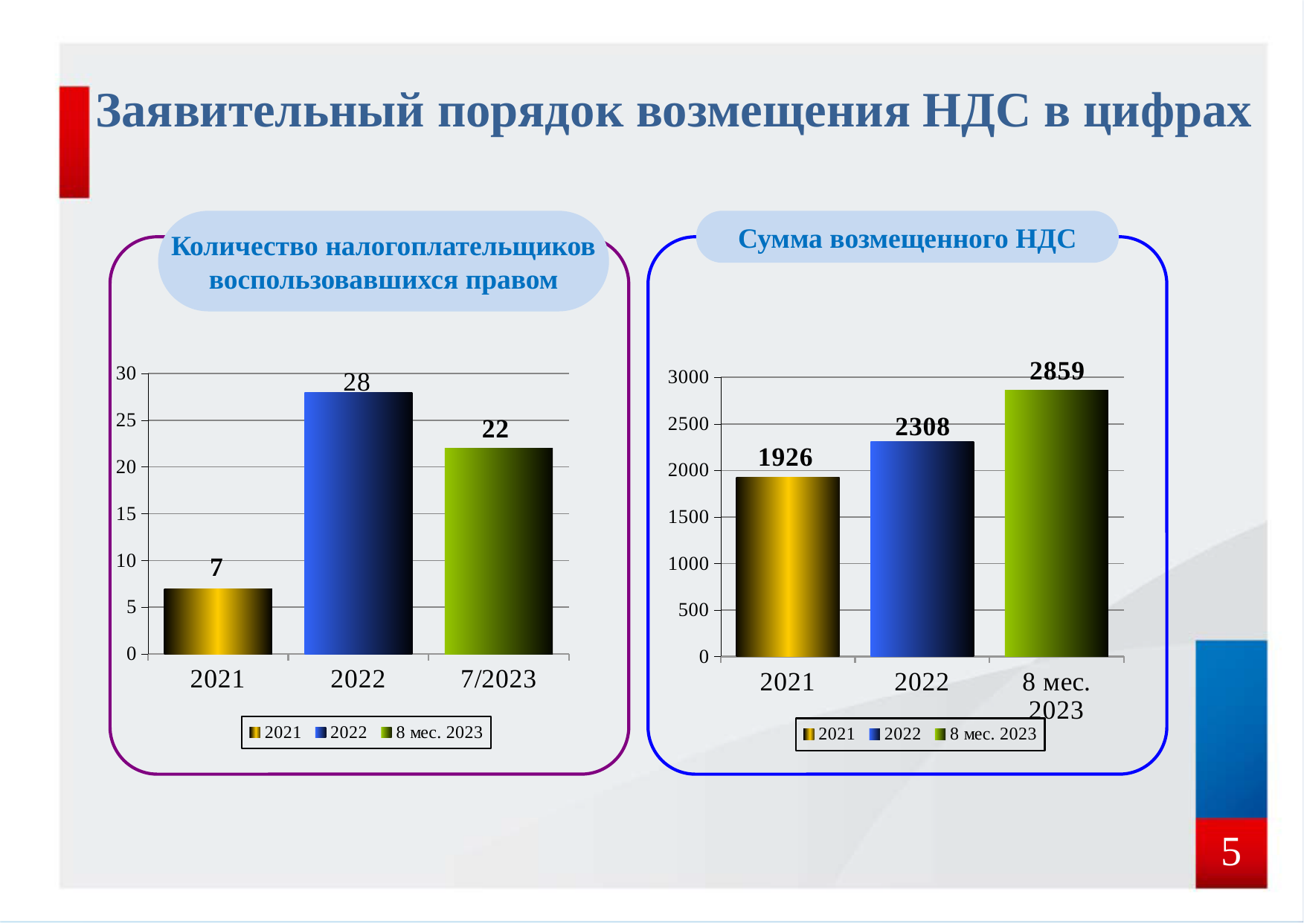
In the right chart (Сумма возмещенного НДС), what is the value for 2021? 1926 What kind of chart is the right chart (Сумма возмещенного НДС)? bar chart In the right chart (Сумма возмещенного НДС), what is the difference between the values for 2022 and 2021? 382 In the left chart (Количество налогоплательщиков воспользовавшихся правом), what is the value for 2022? 28 In the left chart (Количество налогоплательщиков воспользовавшихся правом), how many bars are plotted? 3 In the right chart (Сумма возмещенного НДС), which is larger: the value for 2022 or the value for 8 мес. 2023? 8 мес. 2023 In the left chart (Количество налогоплательщиков воспользовавшихся правом), what is the value for 2021? 7 In the left chart (Количество налогоплательщиков воспользовавшихся правом), which category has the highest value? 2022 In the left chart (Количество налогоплательщиков воспользовавшихся правом), what is the difference between the values for 2022 and 7/2023? 6 In the right chart (Сумма возмещенного НДС), what is the value for 8 мес. 2023? 2859 In the right chart (Сумма возмещенного НДС), which category has the lowest value? 2021 In the right chart (Сумма возмещенного НДС), do the values rise or fall from 2021 to 8 мес. 2023? rise